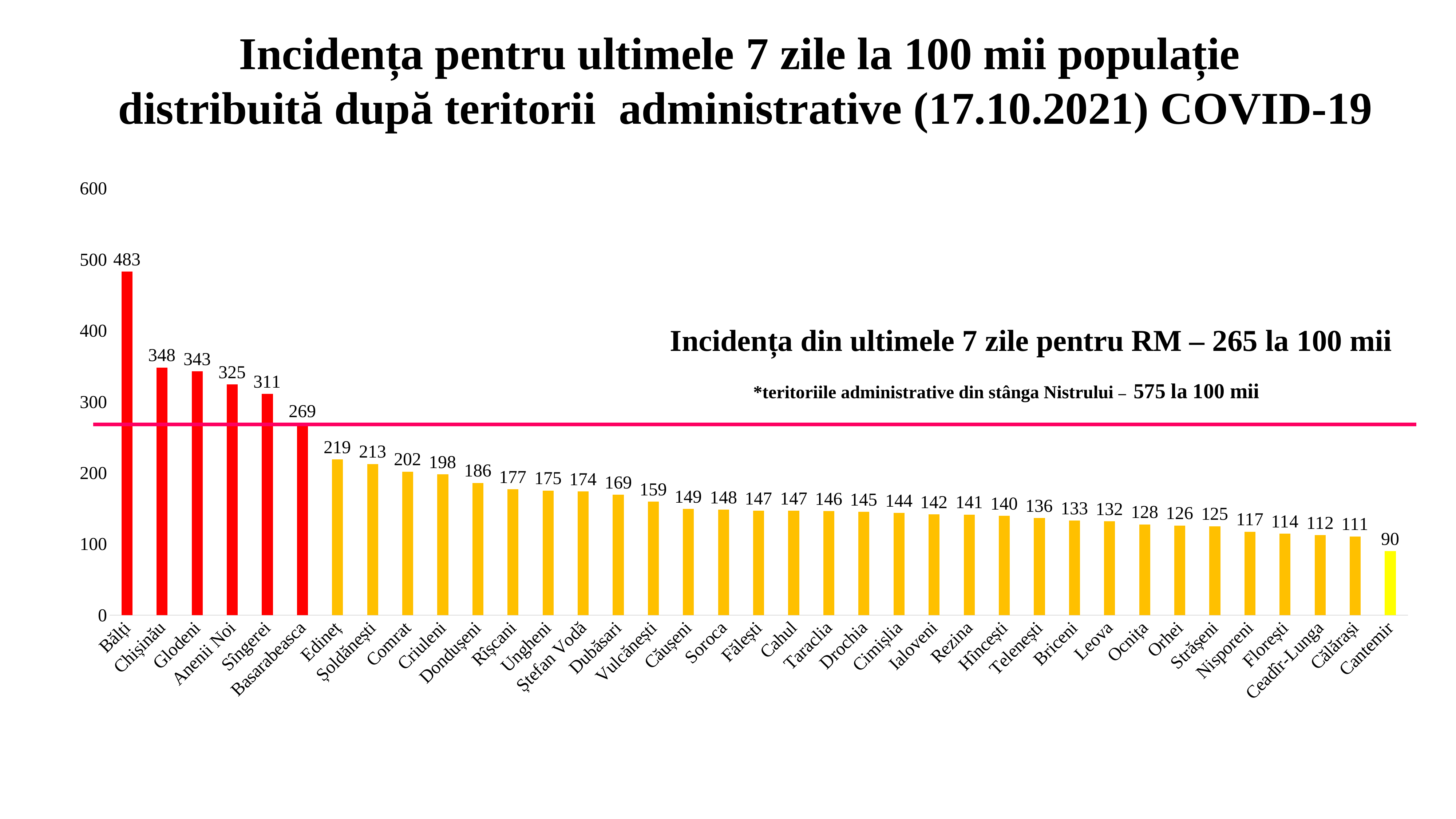
Which is larger, the value for Glodeni or the value for Sîngerei? Glodeni What is the value for Cantemir? 90 How many territories are shown on the chart? 37 What is the value for Chișinău? 348 What is the difference between the values for Bălți and Chișinău? 135 What kind of chart is this? Bar chart What is the value for Bălți? 483 Do the values rise or fall from left to right along the x axis? Fall What is the value for Edineț? 219 What colour is the bar for Cantemir? Yellow Which territory has the highest value? Bălți Which territory has the lowest value? Cantemir